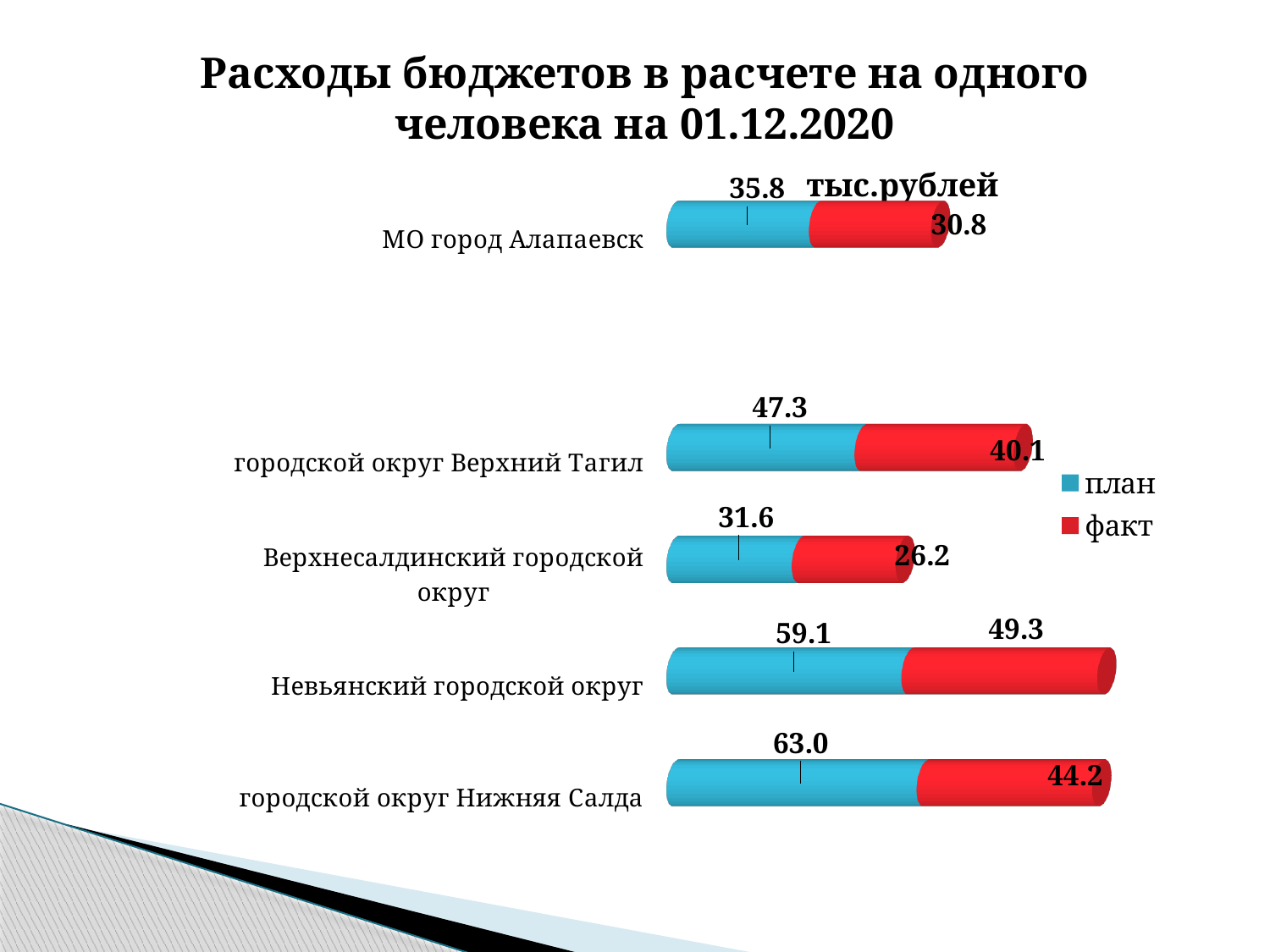
What is the difference between the план and факт values for городской округ Нижняя Салда? 18.8 Which category has the highest план value? городской округ Нижняя Салда What unit is indicated for the values in the chart? тыс.рублей How many series does the legend list? 2 What is the факт value for МО город Алапаевск? 30.8 What is the план value for городской округ Нижняя Салда? 63.0 What is the план value for городской округ Верхний Тагил? 47.3 What is the факт value for Невьянский городской округ? 49.3 Which category has the lowest факт value? Верхнесалдинский городской округ Which is larger: the факт value for Невьянский городской округ or the факт value for городской округ Нижняя Салда? Невьянский городской округ What is the total of the stacked bar for Верхнесалдинский городской округ? 57.8 What kind of chart is shown on the slide? Stacked bar chart